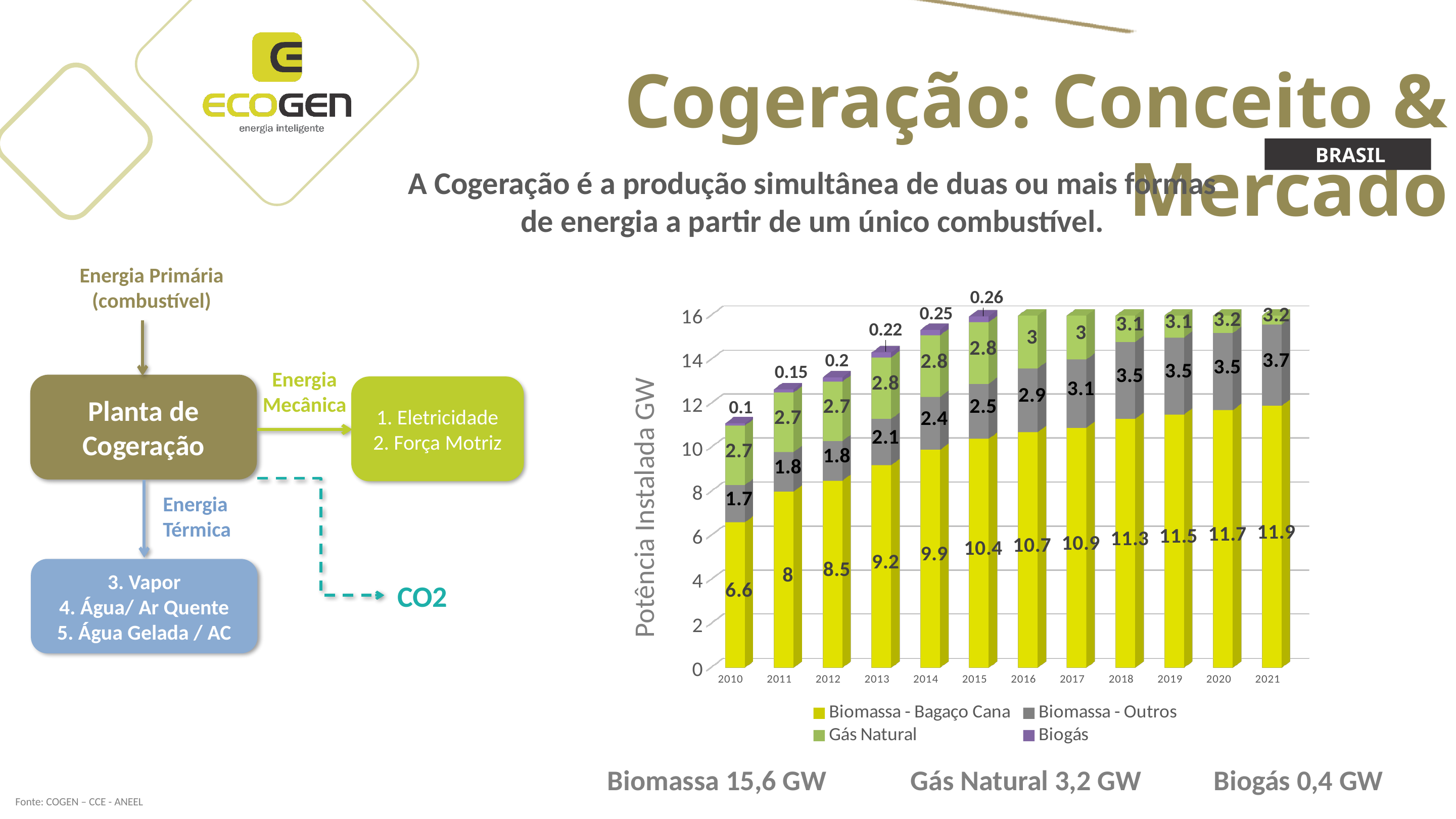
What is the value for Biogás in 2015? 0.26 What is the total of the stacked bar for 2010? 11.1 In which year is the Biomassa - Outros value lowest? 2010 What is the difference between the Biomassa - Bagaço Cana values for 2021 and 2010? 5.3 How many years are shown on the x axis of the chart? 12 Which is larger in 2013: the Biomassa - Outros value or the Gás Natural value? Gás Natural What kind of chart is shown on the slide? Stacked bar chart How many series does the chart legend list? 4 What is the value for Biomassa - Bagaço Cana in 2010? 6.6 What is the value for Gás Natural in 2014? 2.8 What is the value for Biomassa - Outros in 2021? 3.7 In which year is the Biomassa - Bagaço Cana value highest? 2021